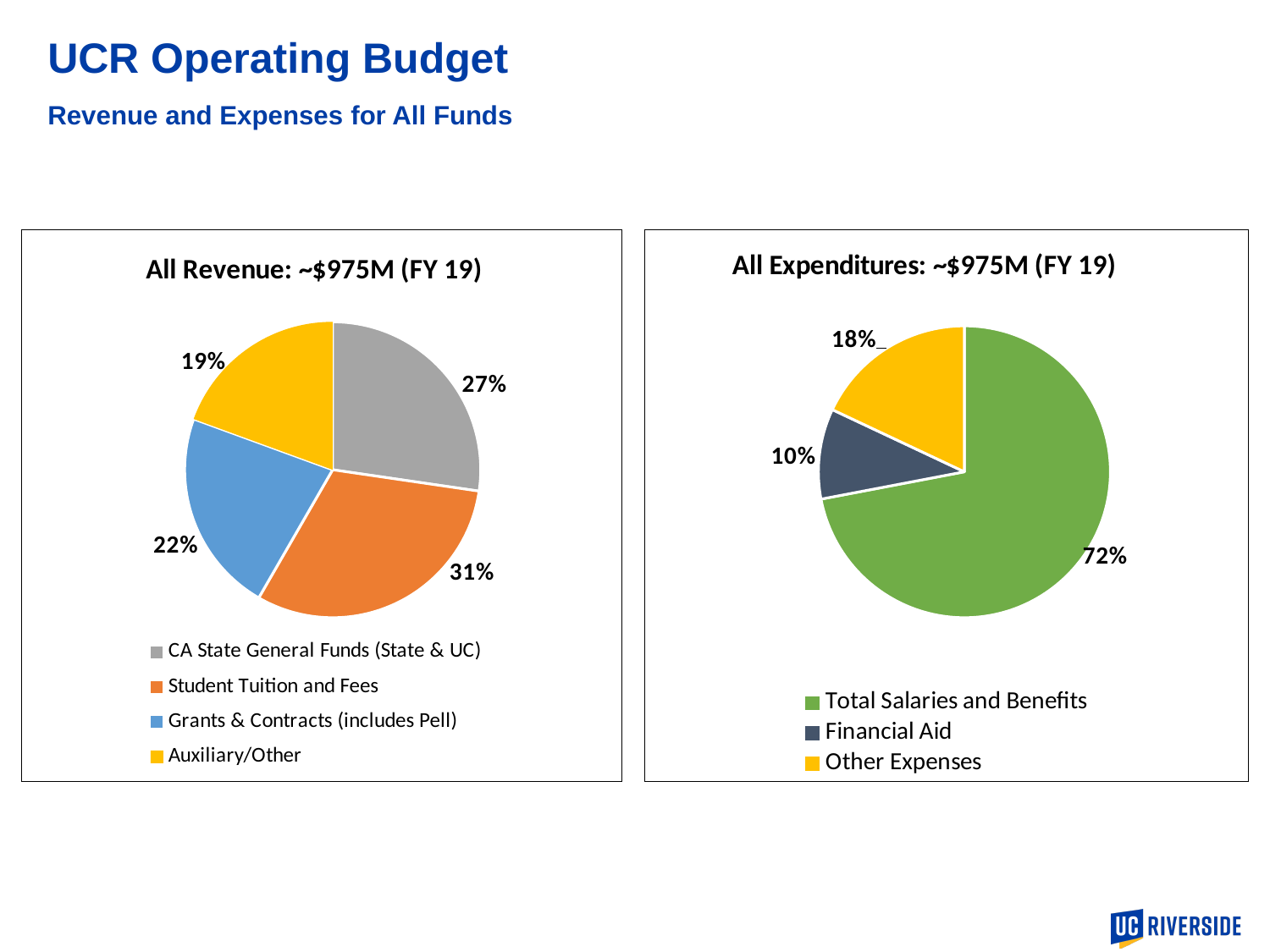
In the 'All Revenue: ~$975M (FY 19)' chart, what is the difference in percentage points between Student Tuition and Fees and Grants & Contracts (includes Pell)? 9 percentage points In the 'All Revenue: ~$975M (FY 19)' chart, which category has the smallest share? Auxiliary/Other In the 'All Revenue: ~$975M (FY 19)' chart, what share of revenue comes from Student Tuition and Fees? 31% In the 'All Expenditures: ~$975M (FY 19)' chart, what share of expenditures goes to Total Salaries and Benefits? 72% In the 'All Expenditures: ~$975M (FY 19)' chart, what share of expenditures goes to Financial Aid? 10% In the 'All Revenue: ~$975M (FY 19)' chart, how many categories does the legend list? 4 In the 'All Revenue: ~$975M (FY 19)' chart, what share of revenue comes from Auxiliary/Other? 19% In the 'All Expenditures: ~$975M (FY 19)' chart, which is larger, Financial Aid or Other Expenses? Other Expenses What type of chart is used for the 'All Expenditures: ~$975M (FY 19)' chart? Pie chart In the 'All Revenue: ~$975M (FY 19)' chart, which category has the largest share? Student Tuition and Fees In the 'All Expenditures: ~$975M (FY 19)' chart, what is the difference in percentage points between Total Salaries and Benefits and Other Expenses? 54 percentage points In the 'All Revenue: ~$975M (FY 19)' chart, what share of revenue comes from CA State General Funds (State & UC)? 27%